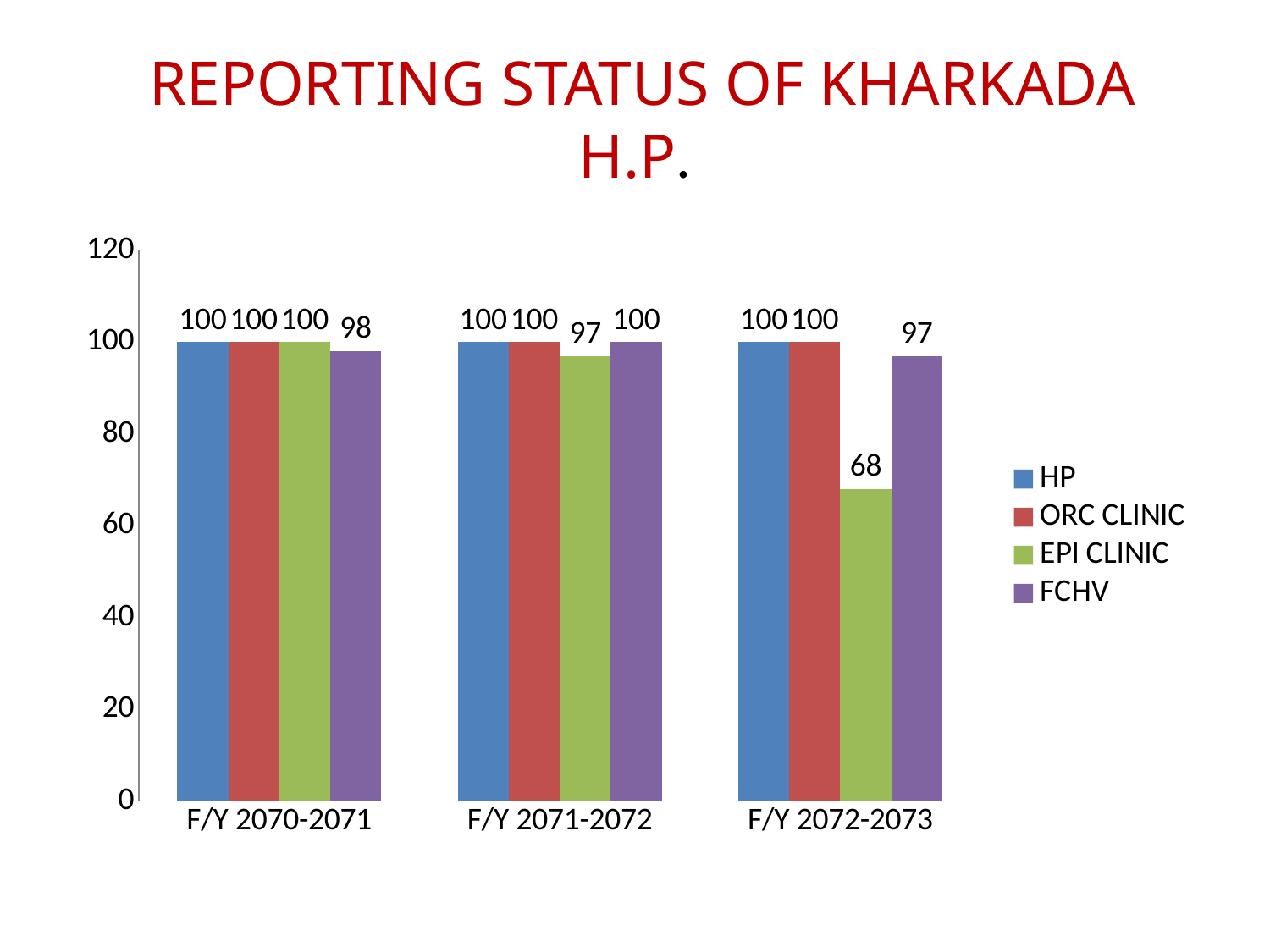
What is the value for FCHV in F/Y 2070-2071? 98 Which series has the lowest value in F/Y 2072-2073? EPI CLINIC What is the value for EPI CLINIC in F/Y 2071-2072? 97 How many series does the legend list? 4 Does the EPI CLINIC value rise or fall across the fiscal years from F/Y 2070-2071 to F/Y 2072-2073? Fall What is the value for FCHV in F/Y 2072-2073? 97 How many fiscal year categories are shown on the x axis? 3 Which is larger in F/Y 2072-2073, the FCHV value or the EPI CLINIC value? FCHV What is the difference between the HP value and the EPI CLINIC value in F/Y 2072-2073? 32 What is the value for EPI CLINIC in F/Y 2072-2073? 68 What kind of chart is shown on the slide? Bar chart What is the difference between the FCHV value in F/Y 2071-2072 and in F/Y 2072-2073? 3